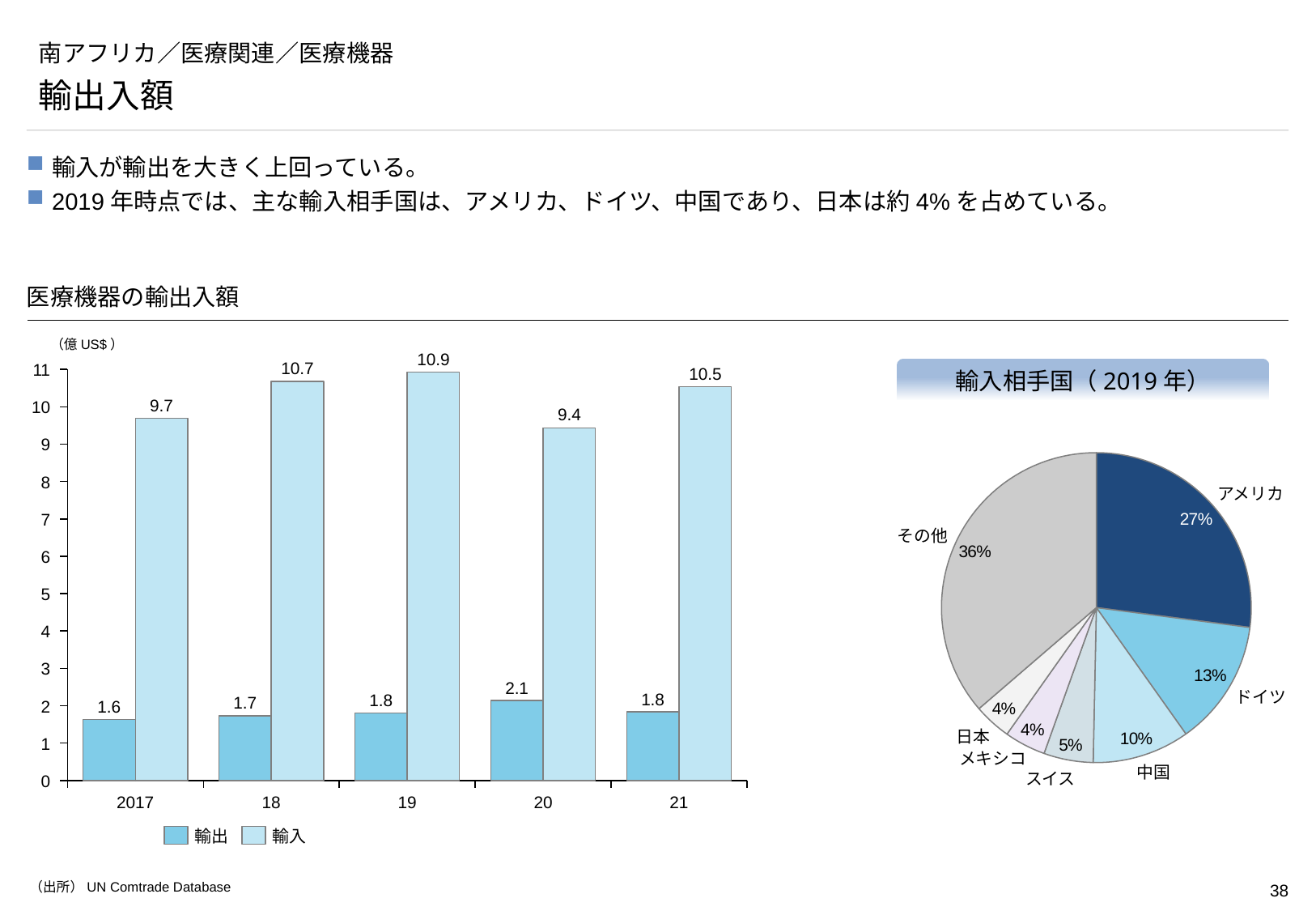
In the bar chart 医療機器の輸出入額, what is the value of 輸入 for 2019? 10.9 What kind of chart is 医療機器の輸出入額? bar chart In the pie chart 輸入相手国（2019年）, what share does アメリカ have? 27% In the bar chart 医療機器の輸出入額, how many series does the legend list? 2 In the bar chart 医療機器の輸出入額, is the 輸入 value for 2020 greater or less than the 輸入 value for 2018? less In the pie chart 輸入相手国（2019年）, what is the difference between the shares of ドイツ and 中国? 3% In the bar chart 医療機器の輸出入額, what is the value of 輸出 for 2020? 2.1 In the bar chart 医療機器の輸出入額, what is the difference between 輸入 and 輸出 in 2021? 8.7 In the pie chart 輸入相手国（2019年）, which named country has the largest share? アメリカ In the bar chart 医療機器の輸出入額, how many years are shown on the x axis? 5 In the bar chart 医療機器の輸出入額, which year has the highest 輸入 value? 2019 In the bar chart 医療機器の輸出入額, which year has the lowest 輸出 value? 2017